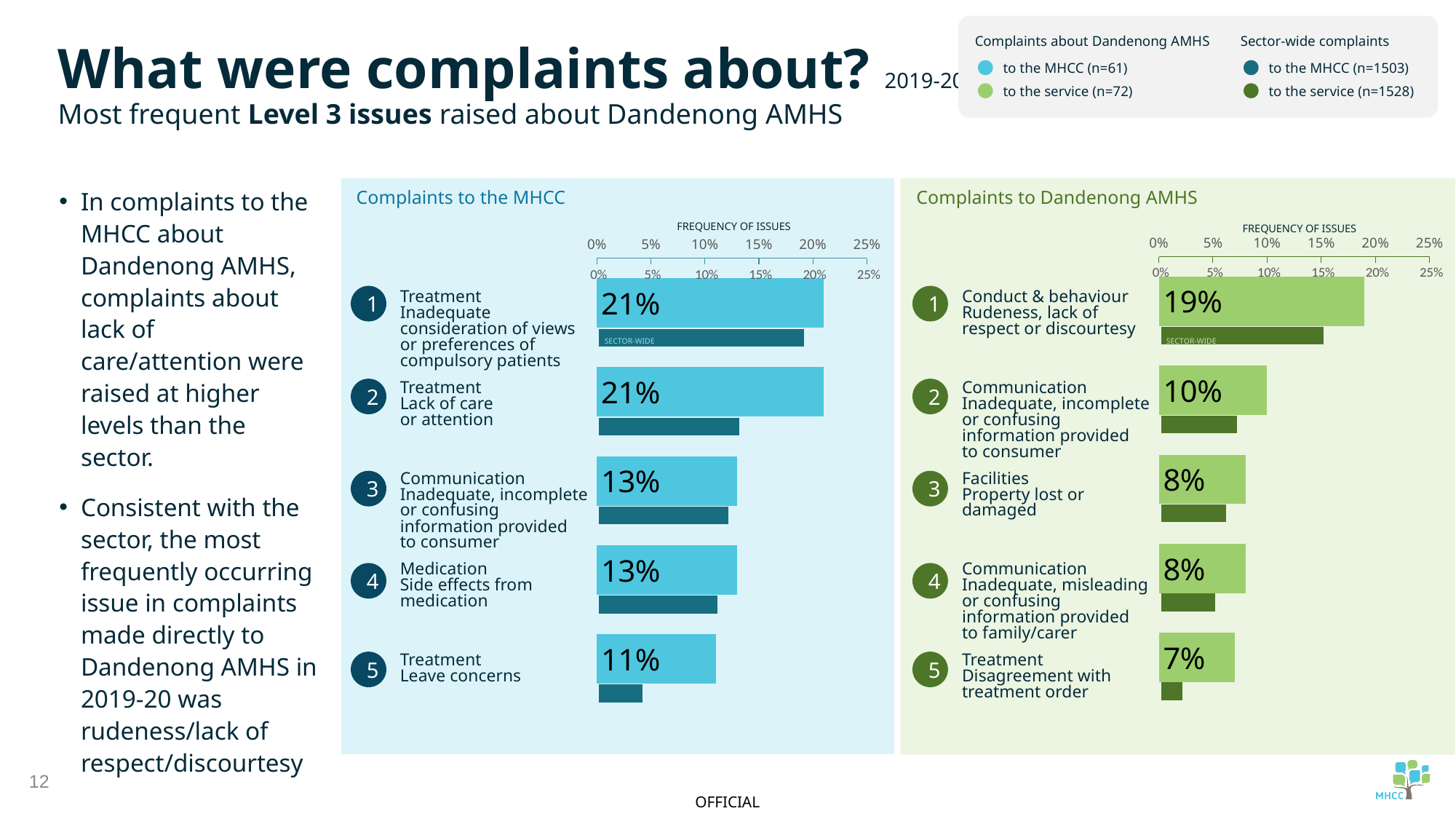
In the 'Complaints to the MHCC' chart, what is the difference between the value for 'Treatment – Lack of care or attention' and the value for 'Medication – Side effects from medication'? 8% In the 'Complaints to Dandenong AMHS' chart, which issue has the highest frequency? Conduct & behaviour – Rudeness, lack of respect or discourtesy In the 'Complaints to Dandenong AMHS' chart, which issue has the lowest frequency? Treatment – Disagreement with treatment order In the 'Complaints to Dandenong AMHS' chart, what is the difference between the value for 'Conduct & behaviour' and the value for 'Communication – Inadequate, incomplete or confusing information provided to consumer'? 9% In the 'Complaints to Dandenong AMHS' chart, what is the value for 'Facilities – Property lost or damaged'? 8% Which is larger: the value for 'Communication – Inadequate, incomplete or confusing information provided to consumer' in the 'Complaints to the MHCC' chart or in the 'Complaints to Dandenong AMHS' chart? Complaints to the MHCC What kind of chart is the 'Complaints to the MHCC' chart? Bar chart In the 'Complaints to the MHCC' chart, is the sector-wide value for 'Treatment – Leave concerns' greater or less than 5%? less How many issues are listed in the 'Complaints to Dandenong AMHS' chart? 5 In the 'Complaints to the MHCC' chart, what is the value for 'Treatment – Leave concerns'? 11% In the 'Complaints to Dandenong AMHS' chart, what is the value for 'Conduct & behaviour – Rudeness, lack of respect or discourtesy'? 19% In the 'Complaints to the MHCC' chart, what is the value for 'Treatment – Lack of care or attention'? 21%